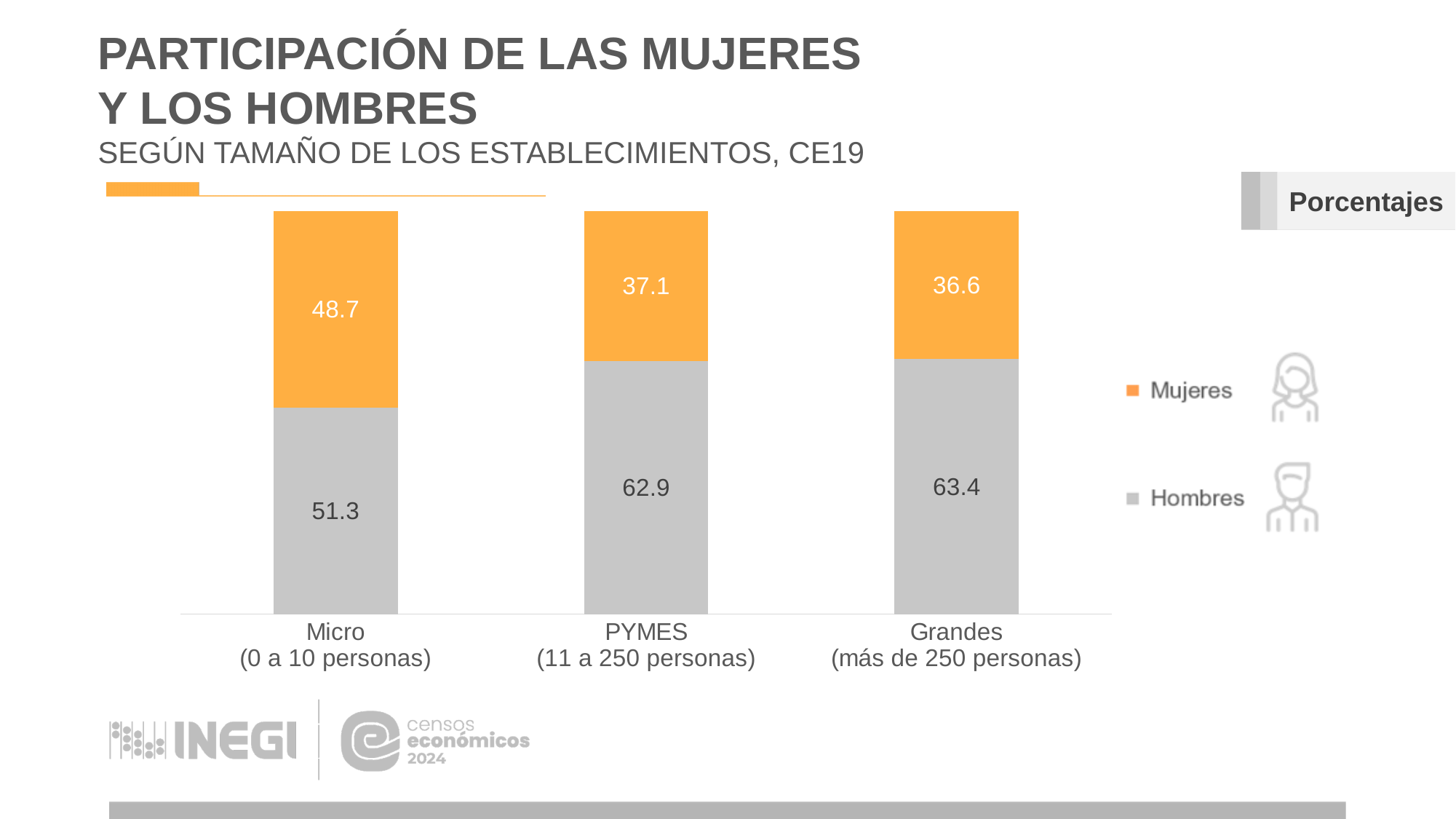
Which establishment size has the highest Mujeres value? Micro (0 a 10 personas) Which establishment size has the lowest Hombres value? Micro (0 a 10 personas) How many series does the legend list? 2 What is the Mujeres value for Micro (0 a 10 personas)? 48.7 What is the Hombres value for PYMES (11 a 250 personas)? 62.9 Which colour represents Mujeres in the chart? Orange Which is larger for Micro (0 a 10 personas): the Hombres value or the Mujeres value? Hombres How many establishment size categories are shown on the chart? 3 What is the difference between the Hombres and Mujeres values for PYMES (11 a 250 personas)? 25.8 What kind of chart is shown on the slide? Stacked bar chart What is the Mujeres value for Grandes (más de 250 personas)? 36.6 What is the Hombres value for Grandes (más de 250 personas)? 63.4